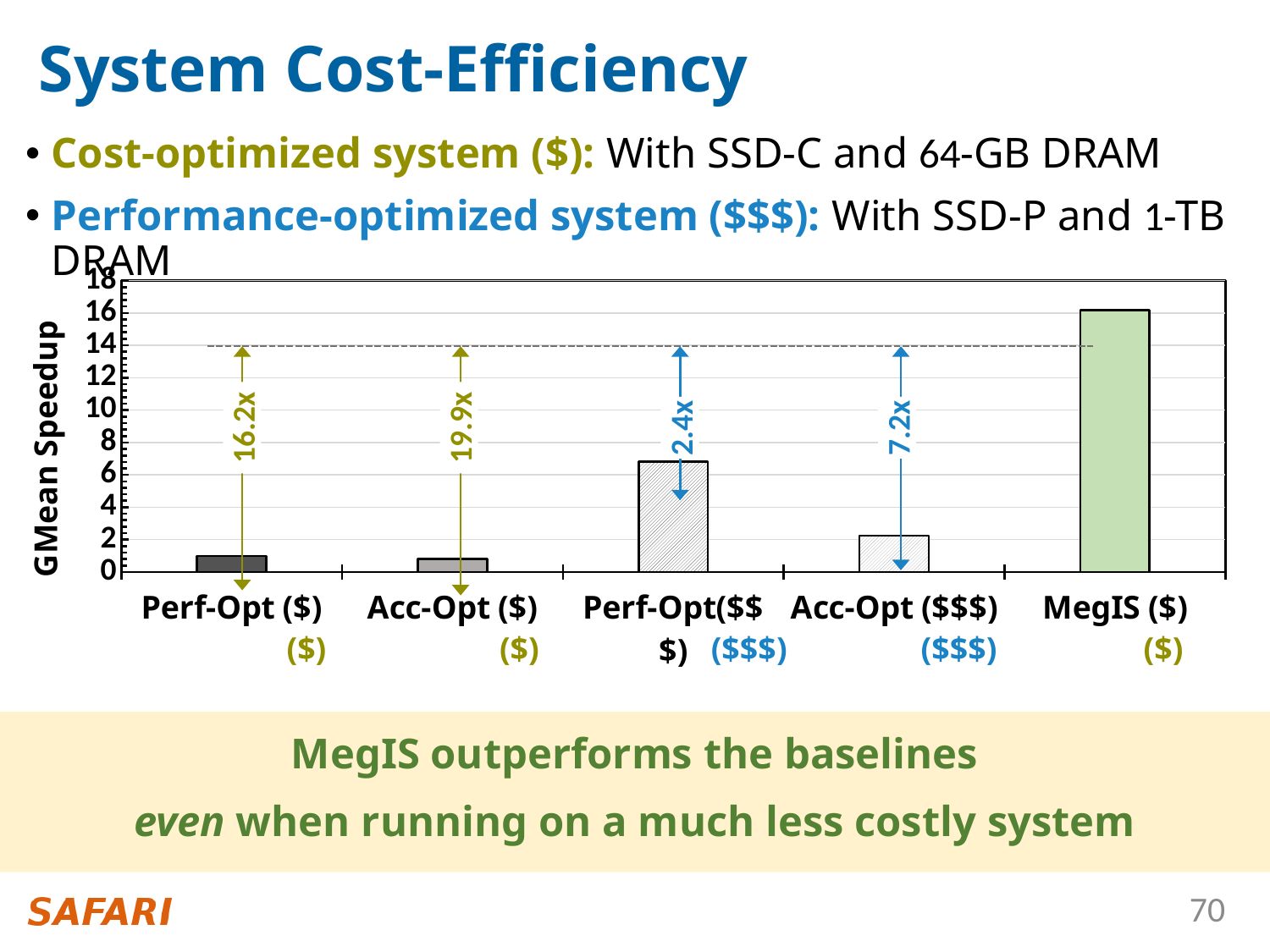
Is the GMean Speedup for Acc-Opt ($$$) greater or less than 4? less Which has a higher GMean Speedup, MegIS ($) or Perf-Opt ($$$)? MegIS ($) What is the label of the y-axis of the chart? GMean Speedup Is the GMean Speedup for Perf-Opt ($$$) greater or less than 8? less Which has a higher GMean Speedup, Perf-Opt ($$$) or Acc-Opt ($$$)? Perf-Opt ($$$) Which category has the highest GMean Speedup? MegIS ($) Is the GMean Speedup for MegIS ($) greater or less than 14? greater What speedup factor is annotated above the Acc-Opt ($$$) bar? 7.2x How many bars (categories) are plotted in the chart? 5 What speedup factor is annotated above the Perf-Opt ($) bar? 16.2x What kind of chart is shown on the slide? bar chart